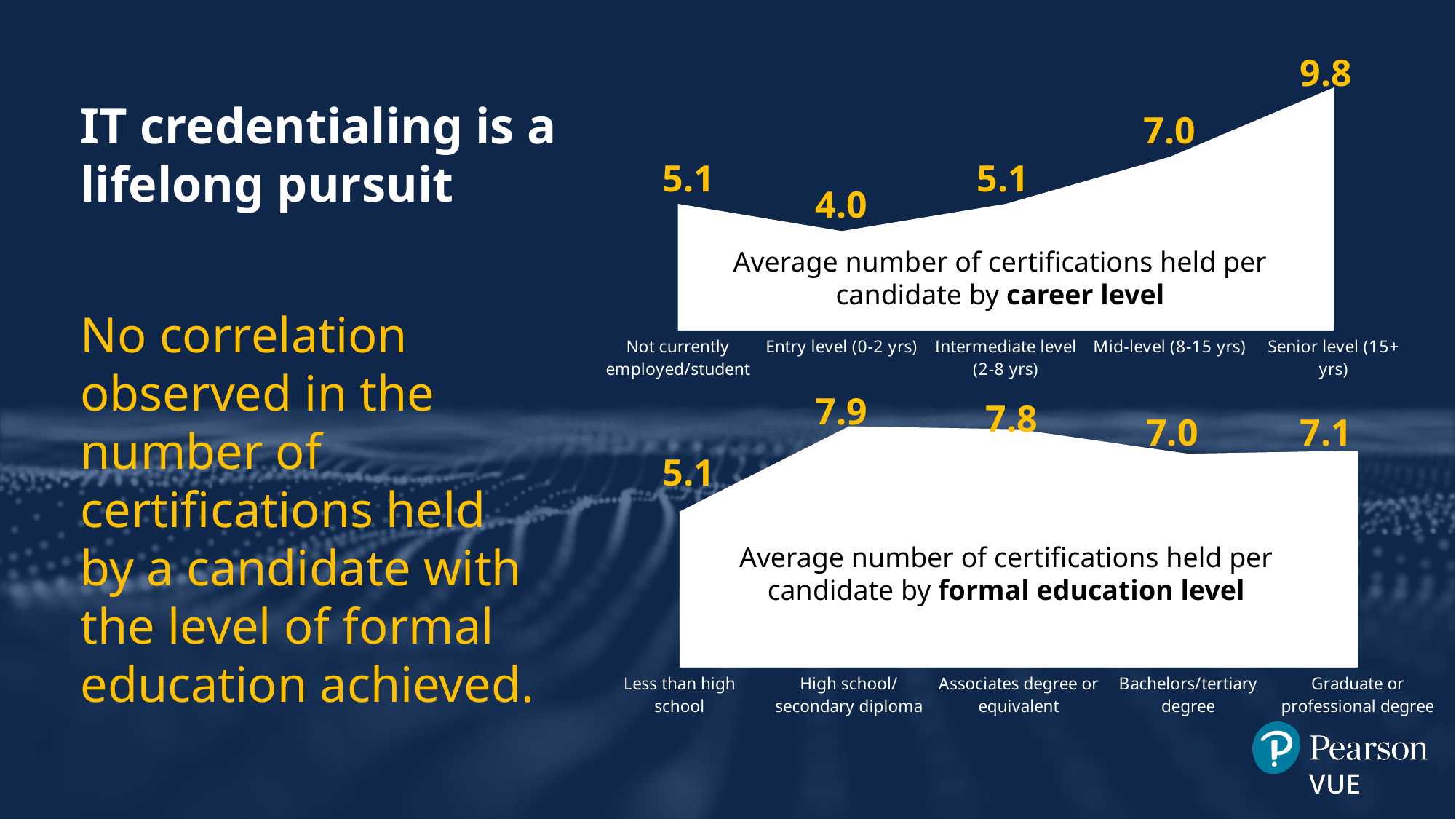
In the chart 'Average number of certifications held per candidate by career level', what is the difference between Senior level (15+ yrs) and Mid-level (8-15 yrs)? 2.8 What type of chart is used for 'Average number of certifications held per candidate by career level'? Area chart In the chart 'Average number of certifications held per candidate by formal education level', what is the value for High school/secondary diploma? 7.9 In the chart 'Average number of certifications held per candidate by career level', what is the value for Senior level (15+ yrs)? 9.8 In the chart 'Average number of certifications held per candidate by career level', how many career level categories are shown? 5 In the chart 'Average number of certifications held per candidate by career level', which career level has the highest value? Senior level (15+ yrs) In the chart 'Average number of certifications held per candidate by formal education level', which education level has the lowest value? Less than high school In the chart 'Average number of certifications held per candidate by formal education level', which is larger: Associates degree or equivalent, or Graduate or professional degree? Associates degree or equivalent In the chart 'Average number of certifications held per candidate by formal education level', what is the difference between High school/secondary diploma and Less than high school? 2.8 In the chart 'Average number of certifications held per candidate by career level', what is the value for Entry level (0-2 yrs)? 4.0 In the chart 'Average number of certifications held per candidate by formal education level', what is the value for Bachelors/tertiary degree? 7.0 In the chart 'Average number of certifications held per candidate by career level', which career level has the lowest value? Entry level (0-2 yrs)